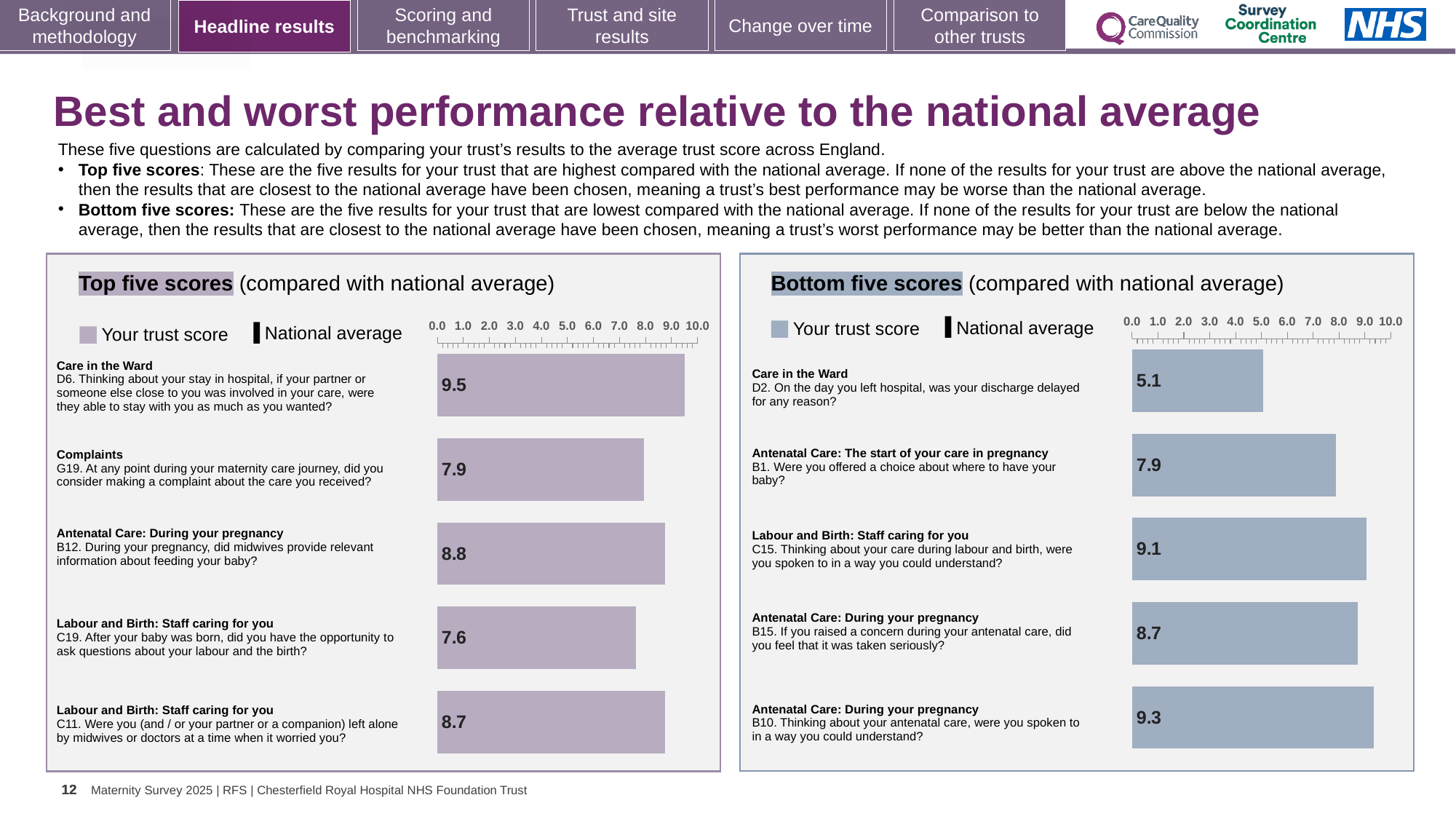
What type of chart is used for the Bottom five scores? Bar chart In the Bottom five scores chart, which question has the lowest trust score? D2. On the day you left hospital, was your discharge delayed for any reason? In the Bottom five scores chart, what is the difference between the trust scores for B10 and D2? 4.2 In the Top five scores chart, what is the trust score for question G19 about considering making a complaint? 7.9 In the Bottom five scores chart, which has the larger trust score: C15 or B15? C15 In the Top five scores chart, which question has the lowest trust score? C19. After your baby was born, did you have the opportunity to ask questions about your labour and the birth? In the Bottom five scores chart, what is the trust score for question D2 about whether your discharge was delayed? 5.1 In the Top five scores chart, what is the difference between the trust scores for D6 and C19? 1.9 How many bars are shown in the Top five scores chart? 5 In the Top five scores chart, what is the trust score for question D6 about whether your partner or someone close to you was able to stay with you as much as you wanted? 9.5 In the Bottom five scores chart, which question has the highest trust score? B10. Thinking about your antenatal care, were you spoken to in a way you could understand? How many entries does the legend of the Top five scores chart list? 2